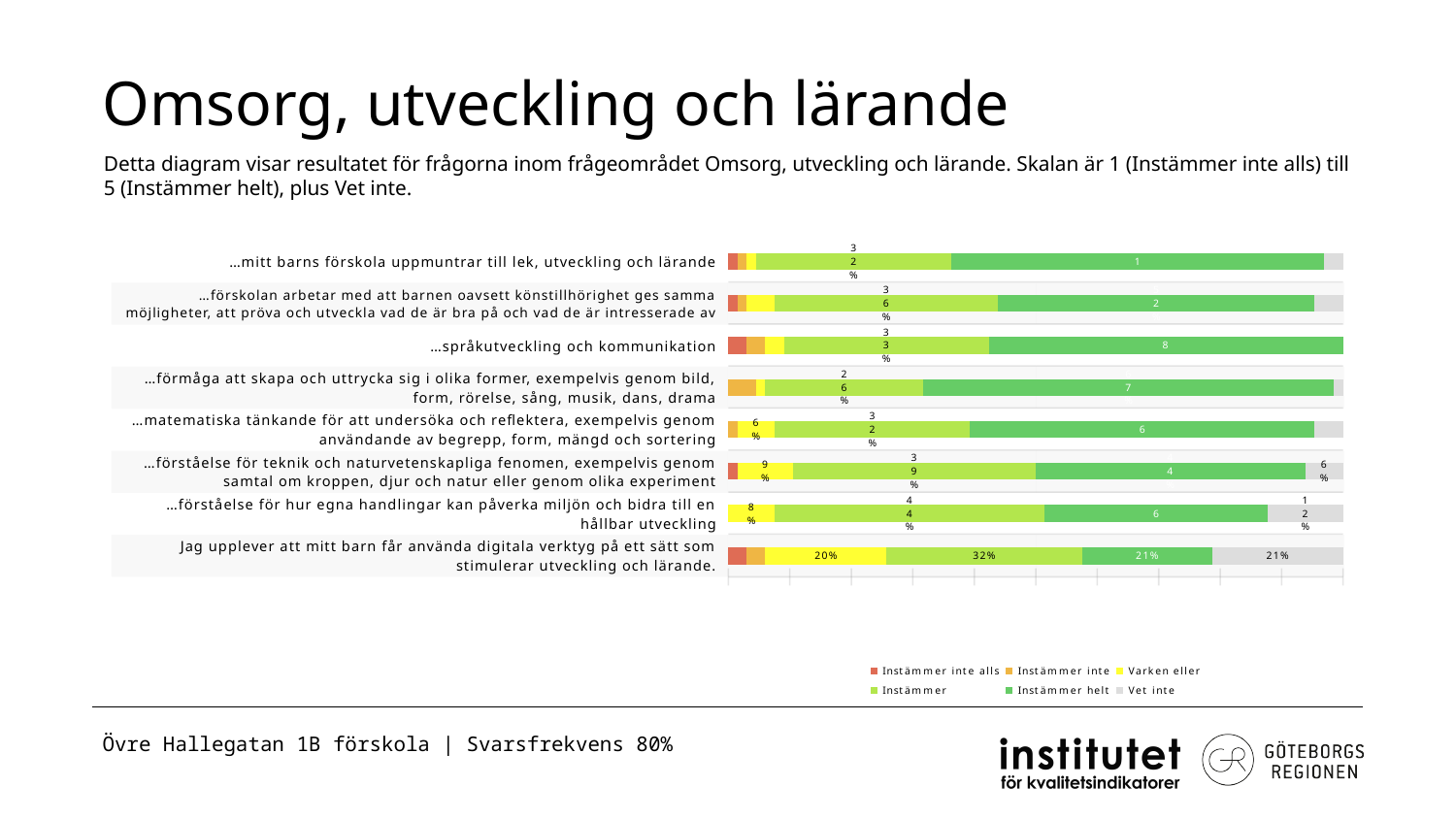
What is the 'Vet inte' value for 'Jag upplever att mitt barn får använda digitala verktyg på ett sätt som stimulerar utveckling och lärande'? 21% Which question category has the largest 'Vet inte' segment? Jag upplever att mitt barn får använda digitala verktyg på ett sätt som stimulerar utveckling och lärande For 'Jag upplever att mitt barn får använda digitala verktyg...', what is the difference between the 'Instämmer' share (32%) and the 'Varken eller' share (20%)? 12 percentage points For 'Jag upplever att mitt barn får använda digitala verktyg...', which is larger: the 'Instämmer' share or the 'Varken eller' share? Instämmer How many series does the chart legend list? 6 What is the 'Instämmer' value for 'Jag upplever att mitt barn får använda digitala verktyg på ett sätt som stimulerar utveckling och lärande'? 32% What is the 'Varken eller' value for 'Jag upplever att mitt barn får använda digitala verktyg på ett sätt som stimulerar utveckling och lärande'? 20% Which legend entry is shown in dark green? Instämmer helt Which question category has the smallest 'Instämmer helt' segment? Jag upplever att mitt barn får använda digitala verktyg på ett sätt som stimulerar utveckling och lärande How many question categories (bars) are plotted in the chart? 8 What kind of chart is shown on the slide? Stacked bar chart What is the 'Instämmer helt' value for 'Jag upplever att mitt barn får använda digitala verktyg på ett sätt som stimulerar utveckling och lärande'? 21%